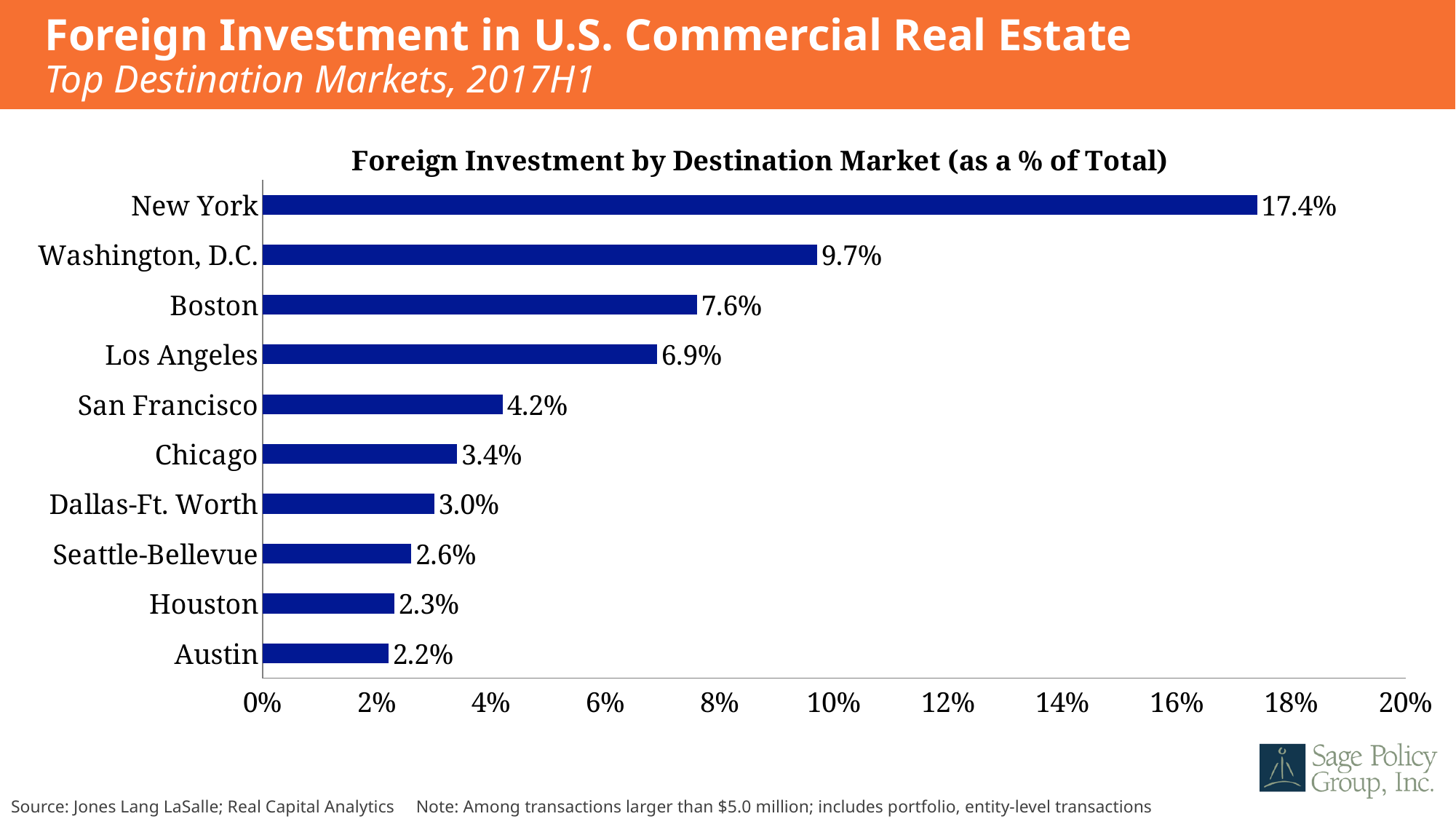
What is the value for Seattle-Bellevue? 2.6% What is the title of the chart? Foreign Investment by Destination Market (as a % of Total) Which is larger, the value for Chicago or the value for Dallas-Ft. Worth? Chicago What kind of chart is shown on the slide? bar chart What is the value for Boston? 7.6% How many destination markets are shown in the chart? 10 What is the difference between the values for Los Angeles and San Francisco? 2.7% What is the difference between the values for New York and Washington, D.C.? 7.7% What is the value for New York? 17.4% Is the value for Washington, D.C. greater or less than 10%? less Which destination market has the highest share of foreign investment? New York Which destination market has the lowest share of foreign investment? Austin